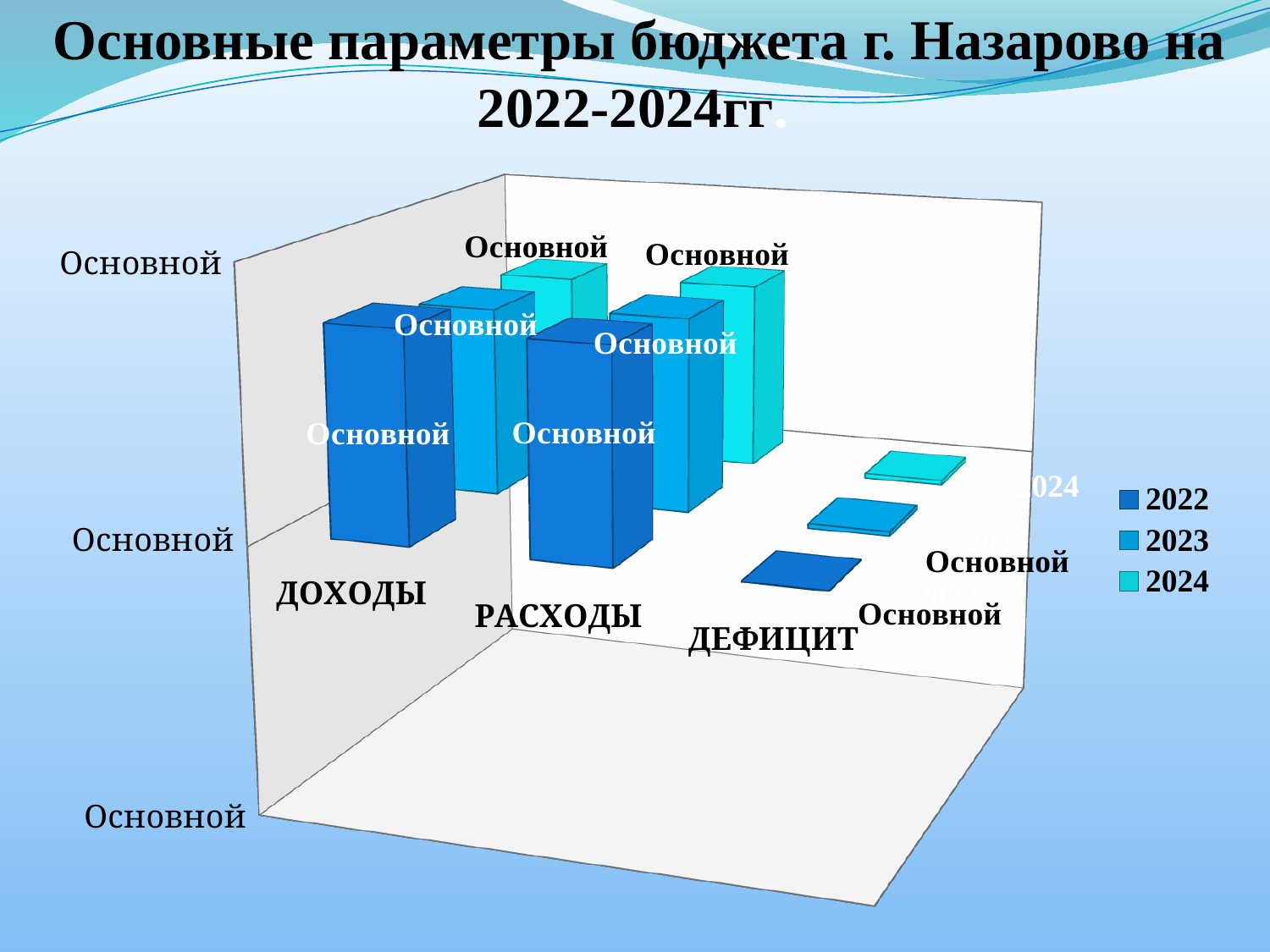
For the 2024 series, which is larger: РАСХОДЫ or ДЕФИЦИТ? РАСХОДЫ How many series does the chart's legend list? 3 What is the title of the chart on the slide? Основные параметры бюджета г. Назарово на 2022-2024гг. What are the three categories shown along the x axis of the chart? ДОХОДЫ, РАСХОДЫ, ДЕФИЦИТ What kind of chart is shown on the slide? bar chart For the 2022 series, which is larger: ДОХОДЫ or ДЕФИЦИТ? ДОХОДЫ For the 2023 series, which is larger: ДОХОДЫ or ДЕФИЦИТ? ДОХОДЫ Which years are listed in the chart's legend? 2022, 2023, 2024 How many categories are shown on the x axis of the chart? 3 Which category has the lowest bars in the chart? ДЕФИЦИТ